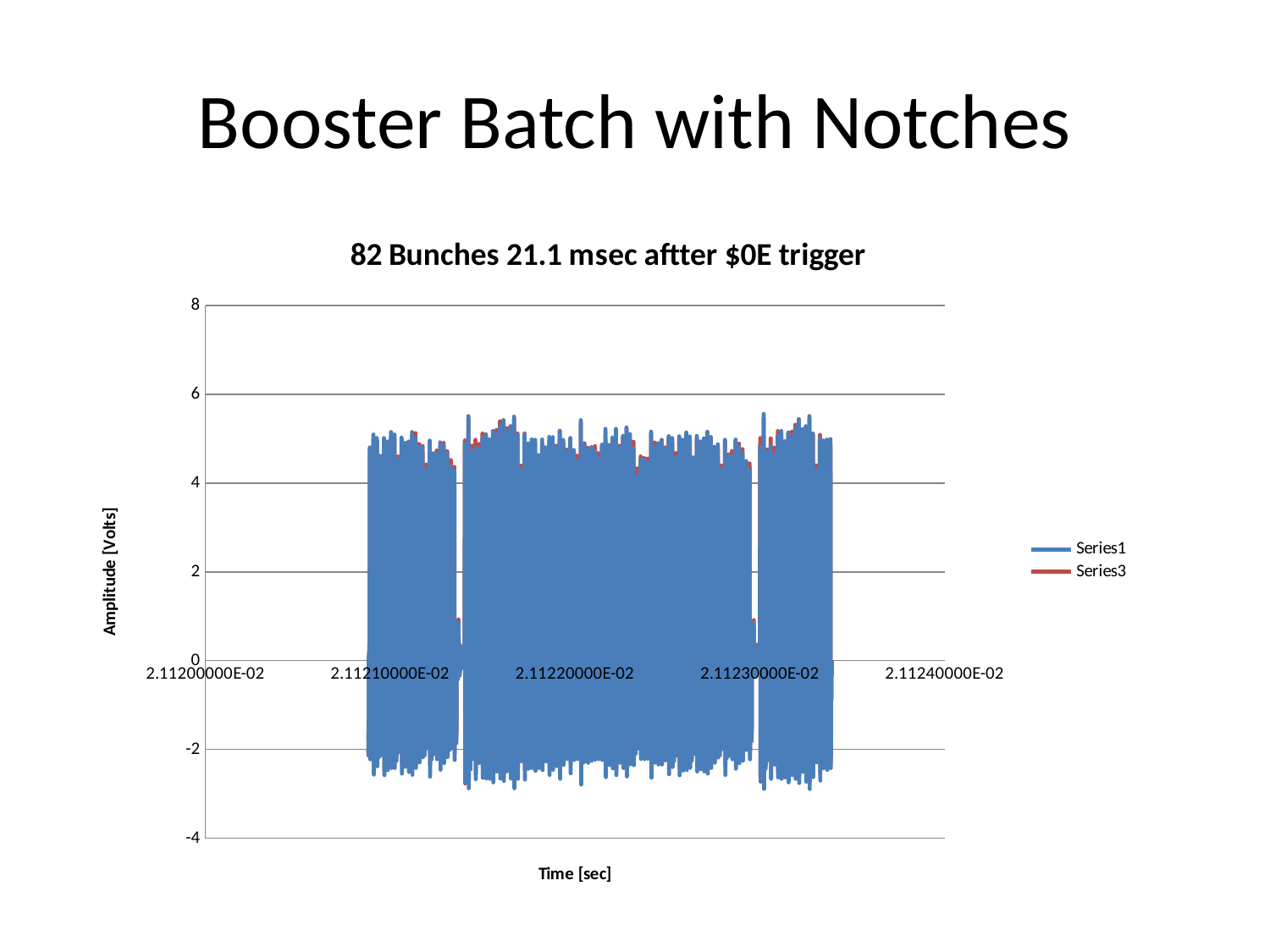
Is the lowest amplitude reached by the signal greater or less than -2 volts? less How many series does the legend list? 2 What kind of chart is shown on the slide? line chart What is the title of the chart? 82 Bunches 21.1 msec aftter $0E trigger Is the lowest amplitude reached by the signal greater or less than -4 volts? greater Is the highest amplitude reached by the signal greater or less than 4 volts? greater What are the names of the two series in the legend? Series1 and Series3